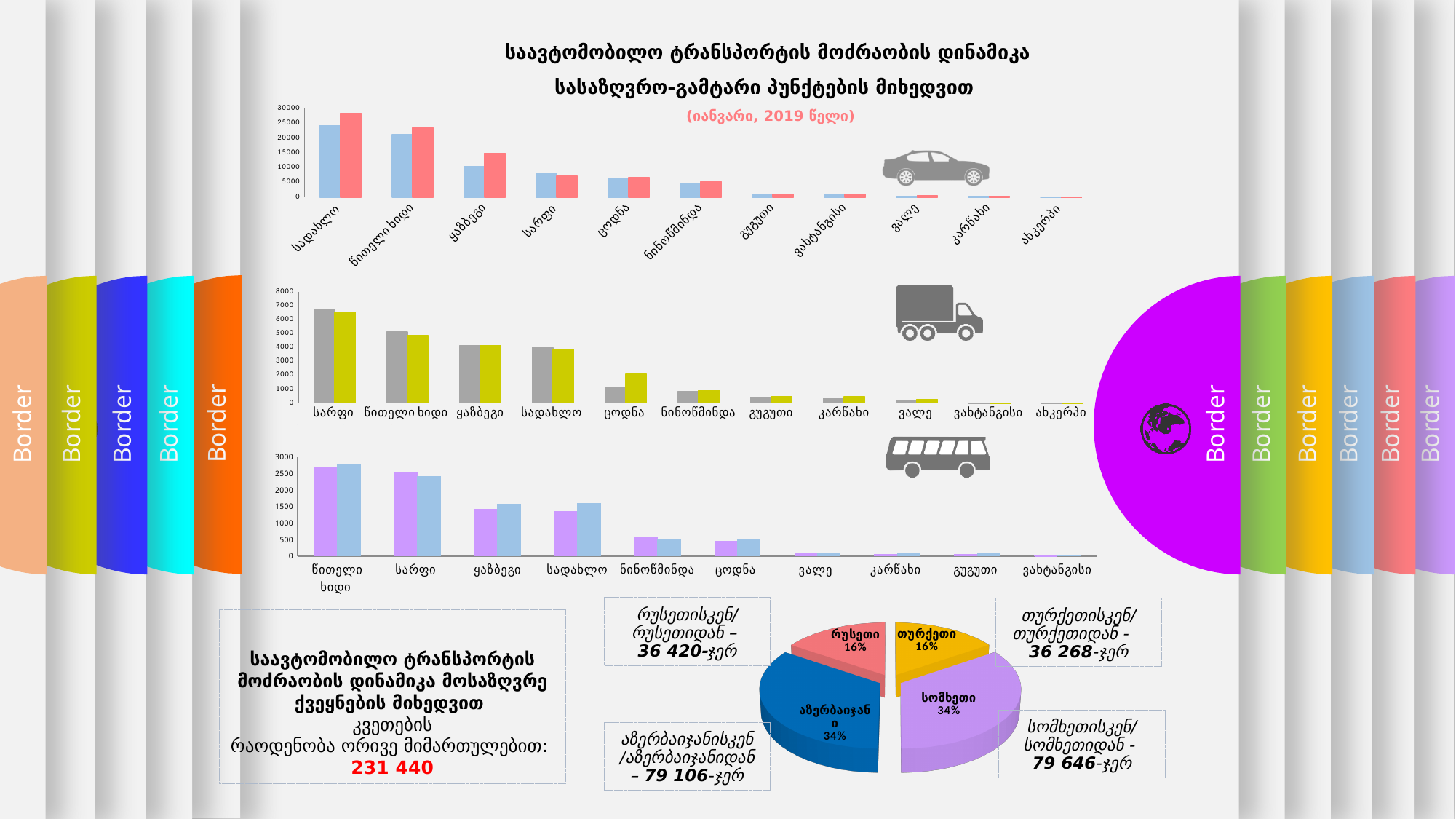
How many categories are shown on the x axis of the top chart (with the car icon)? 11 In the bottom bar chart (with the bus icon), which category has the highest values? წითელი ხიდი In the pie chart, what share does სომხეთი have? 34% In the middle chart (with the truck icon), for ცოდნა, which bar is larger: the gray one or the yellow-green one? the yellow-green one In the top chart (with the car icon), is the red bar for სადახლო greater or less than 25000? greater In the middle chart (with the truck icon), which category has the highest values? სარფი What kind of chart is the top chart (with the car icon)? bar chart In the top chart (with the car icon), is the value for სარფი greater or less than 10000? less How many slices does the pie chart have? 4 In the middle chart (with the truck icon), is the gray bar for სარფი greater or less than 6000? greater How many categories are shown on the x axis of the bottom bar chart (with the bus icon)? 10 In the top chart (with the car icon), which category has the highest values? სადახლო